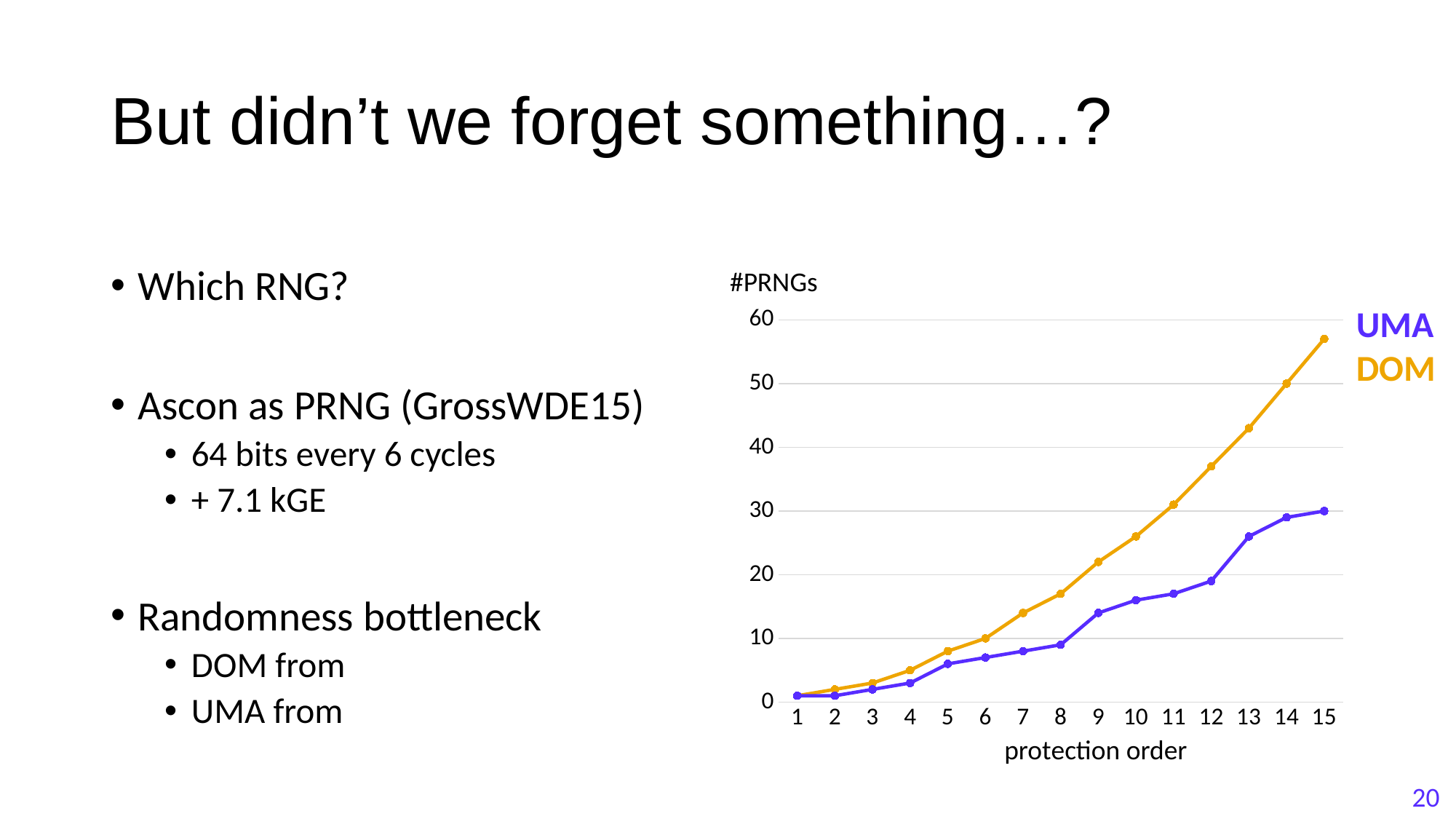
What is the label of the x axis? protection order How many protection order values are plotted along the x axis? 15 Is the DOM value at protection order 15 greater or less than 50? greater At which protection order does the DOM series reach its highest value? 15 What kind of chart is shown on the slide? line chart Which colour is used for the UMA series? purple Do the DOM values rise or fall as the protection order increases? rise Is the DOM value at protection order 12 greater or less than 30? greater How many series does the chart's legend list? 2 Is the UMA value at protection order 15 greater or less than 40? less Which series has the higher number of PRNGs at protection order 15, UMA or DOM? DOM